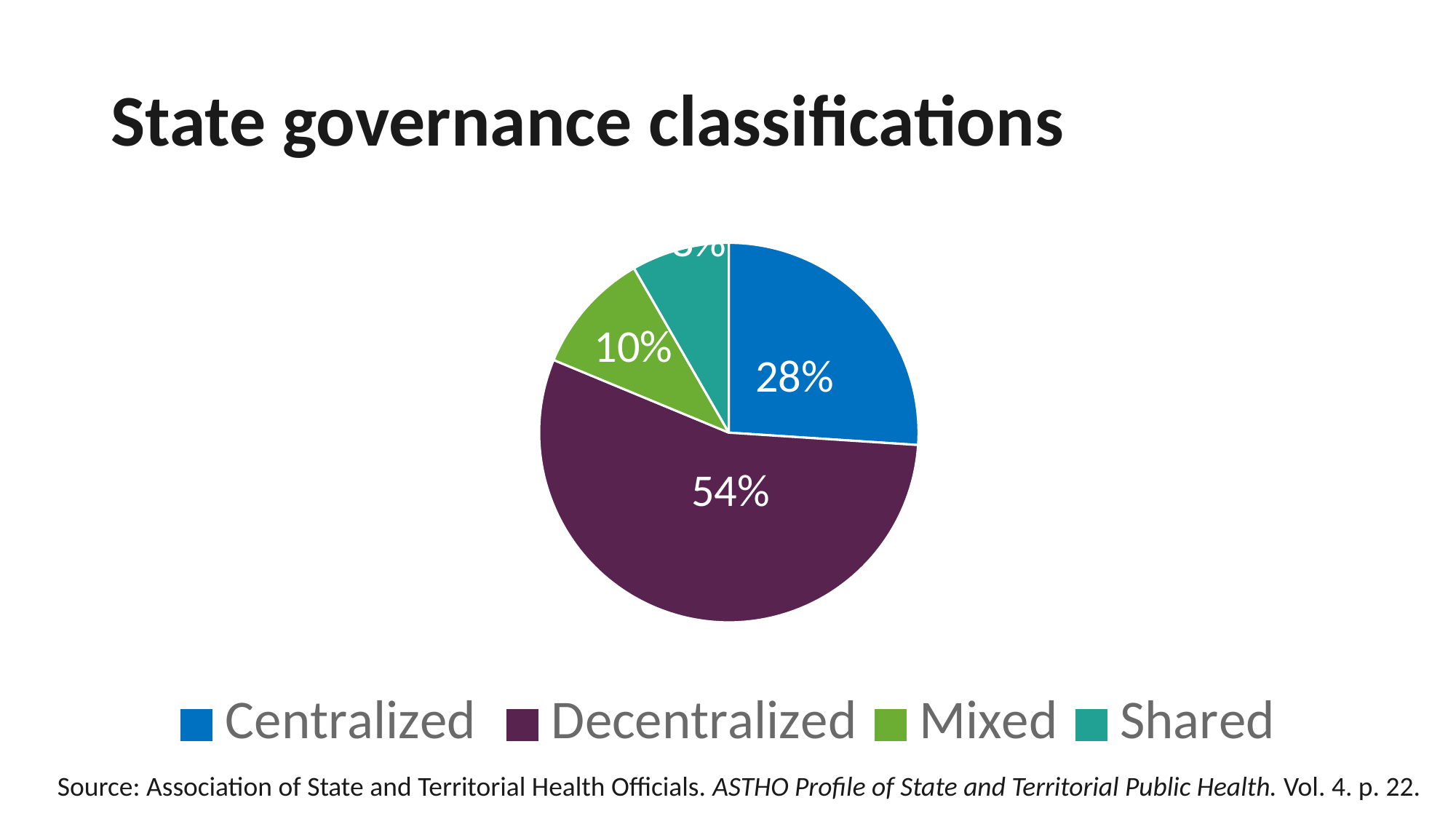
What is the title of the slide? State governance classifications Which governance classification has the largest slice of the pie? Decentralized How many percentage points larger is Decentralized than Centralized? 26% What kind of chart is shown on the slide? pie chart Which is larger, the Decentralized slice or the Centralized slice? Decentralized How many categories does the legend list? 4 Which is larger, the Centralized slice or the Mixed slice? Centralized What colour is the Decentralized slice? purple What percentage of the pie is Centralized? 28% What percentage of the pie is Mixed? 10% How many percentage points larger is Centralized than Mixed? 18% What percentage of the pie is Decentralized? 54%